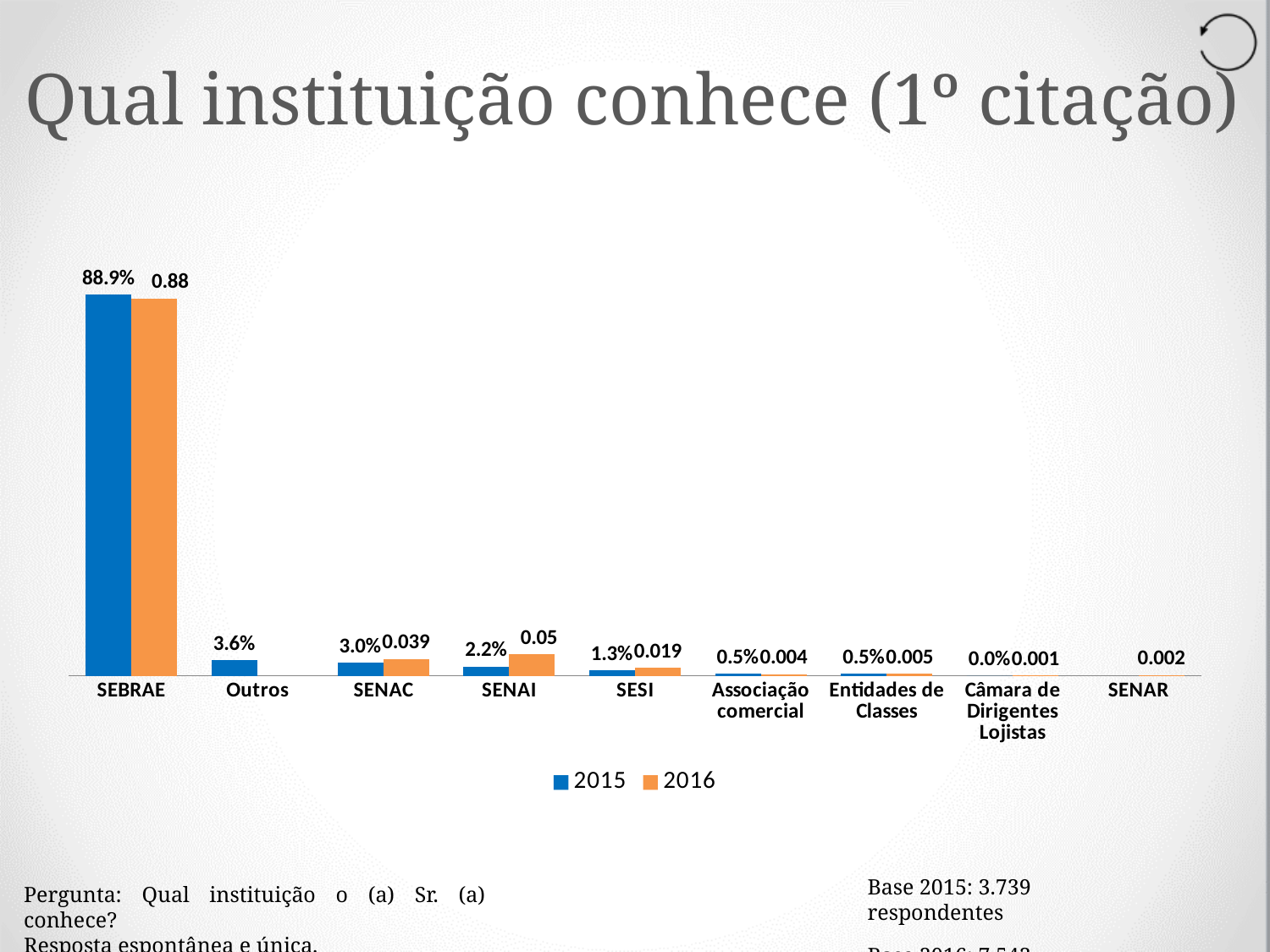
What is the 2015 value for Outros? 3.6% What type of chart is shown on the slide? bar chart How many categories are shown on the x axis? 9 What is the 2016 value for SENAI? 0.05 What is the difference between the 2015 values for SEBRAE and Outros? 85.3% What is the 2016 value for SEBRAE? 0.88 Which is larger, the 2015 value for SENAC or the 2015 value for SESI? SENAC Which category has the lowest 2015 value? Câmara de Dirigentes Lojistas How many series does the legend list? 2 What is the 2016 value for SENAR? 0.002 Which category has the highest 2015 value? SEBRAE What is the 2015 value for SEBRAE? 88.9%